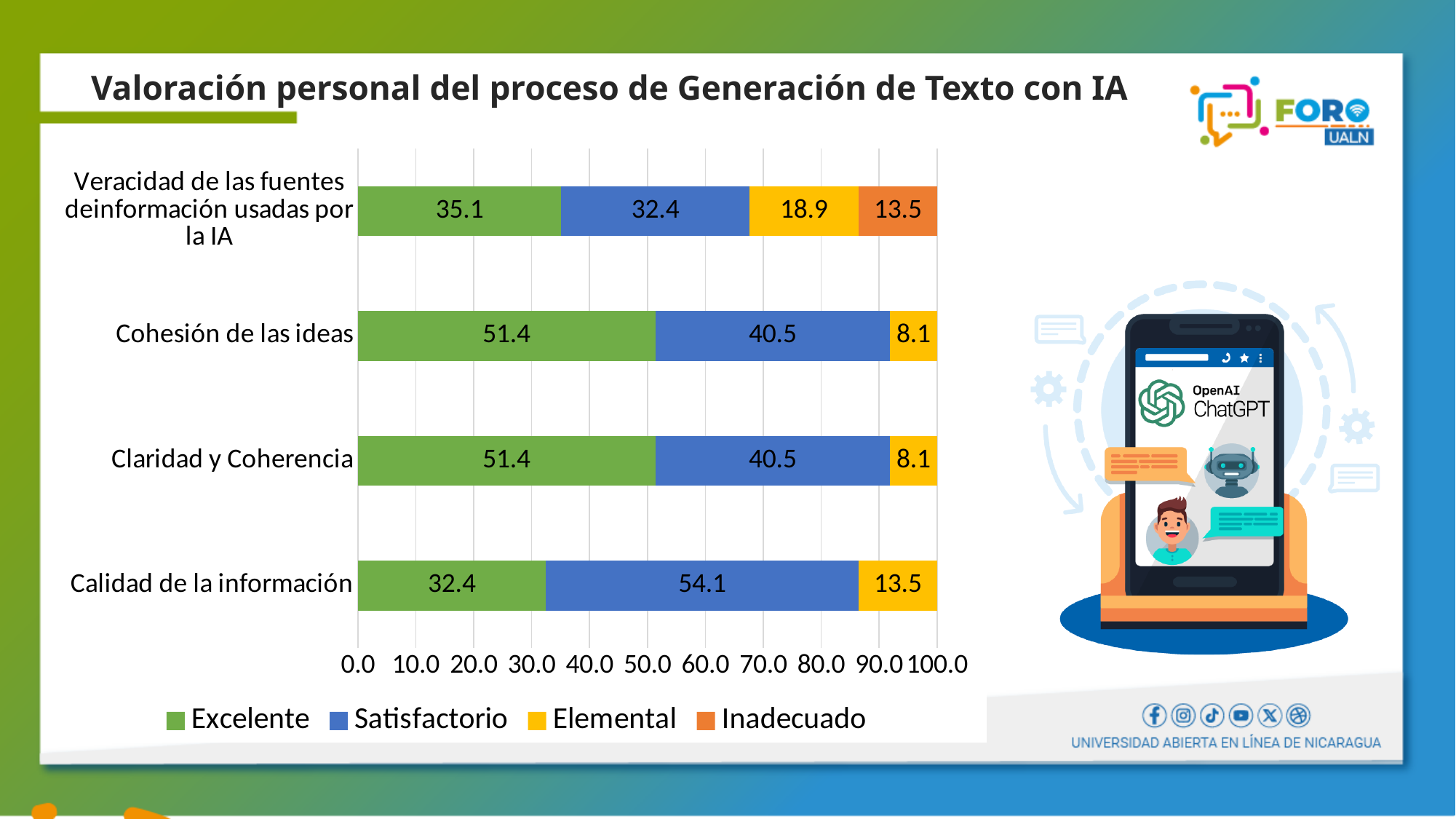
What is the Satisfactorio value for Calidad de la información? 54.1 What is the Elemental value for Veracidad de las fuentes de información usadas por la IA? 18.9 Which has the larger Excelente value: Veracidad de las fuentes de información usadas por la IA or Calidad de la información? Veracidad de las fuentes de información usadas por la IA How many categories are shown on the chart? 4 What is the Excelente value for Cohesión de las ideas? 51.4 Which category has the highest Satisfactorio value? Calidad de la información Which category has the lowest Excelente value? Calidad de la información What is the total of the stacked bar for Veracidad de las fuentes de información usadas por la IA? 99.9 What kind of chart is shown on the slide? Stacked bar chart How many series does the legend list? 4 What is the Inadecuado value for Veracidad de las fuentes de información usadas por la IA? 13.5 For Calidad de la información, how much larger is the Satisfactorio value than the Excelente value? 21.7